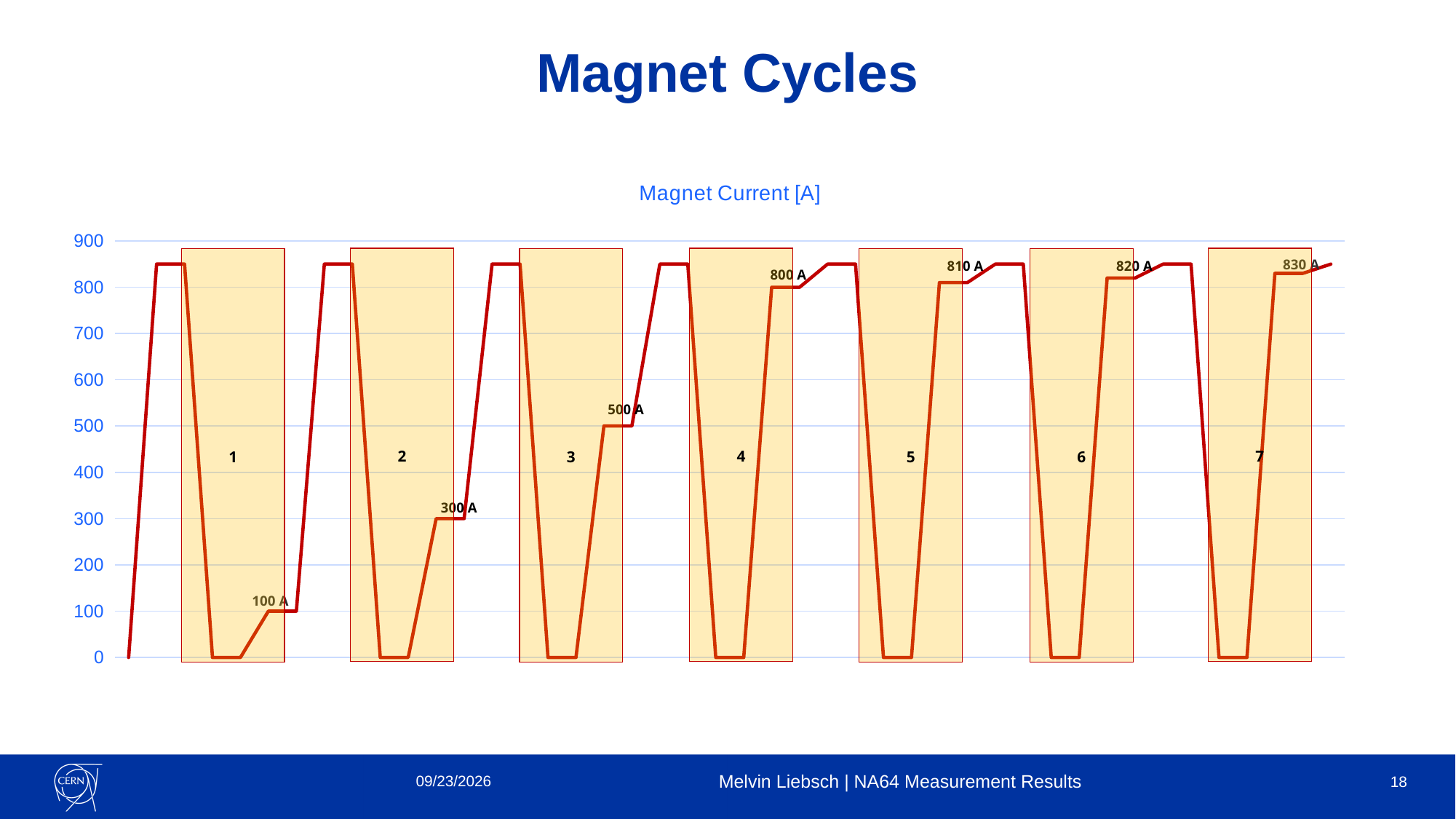
Is the peak current reached at the top of each cycle greater or less than 800? greater What is the difference between the labelled plateau currents of cycle 7 (830 A) and cycle 4 (800 A)? 30 A How many numbered shaded cycle regions are marked on the chart? 7 Which labelled plateau current is the highest? 830 A Which labelled plateau current is the lowest? 100 A What current value is labelled on the plateau in cycle 3? 500 A What is the title of the chart? Magnet Current [A] What current value is labelled on the plateau in cycle 7? 830 A What current value is labelled on the plateau in cycle 5? 810 A What current value is labelled on the plateau in cycle 1? 100 A Do the labelled plateau currents rise or fall from cycle 1 to cycle 7? rise What kind of chart is shown on the slide? line chart